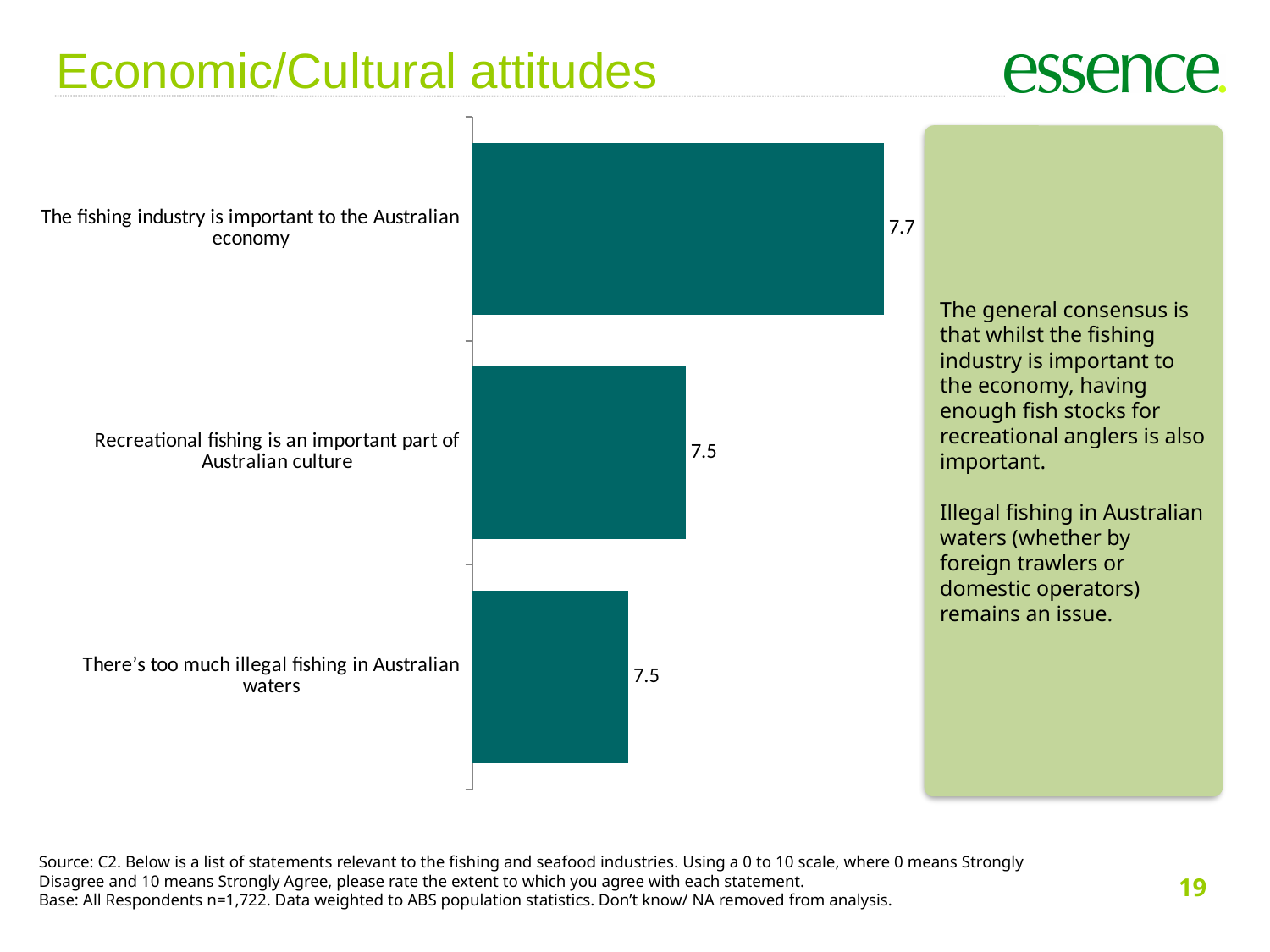
What is the title of the slide containing the chart? Economic/Cultural attitudes Which has a higher score: 'The fishing industry is important to the Australian economy' or 'There's too much illegal fishing in Australian waters'? The fishing industry is important to the Australian economy What is the value shown for 'Recreational fishing is an important part of Australian culture'? 7.5 Which statement has the highest agreement score on the chart? The fishing industry is important to the Australian economy What is the difference between the score for 'The fishing industry is important to the Australian economy' and the score for 'Recreational fishing is an important part of Australian culture'? 0.2 How many statements are plotted on the chart? 3 What colour are the bars in the chart? Dark teal What is the mean agreement score for the statement 'The fishing industry is important to the Australian economy'? 7.7 What is the value shown for 'There's too much illegal fishing in Australian waters'? 7.5 What type of chart is shown on the slide? Bar chart